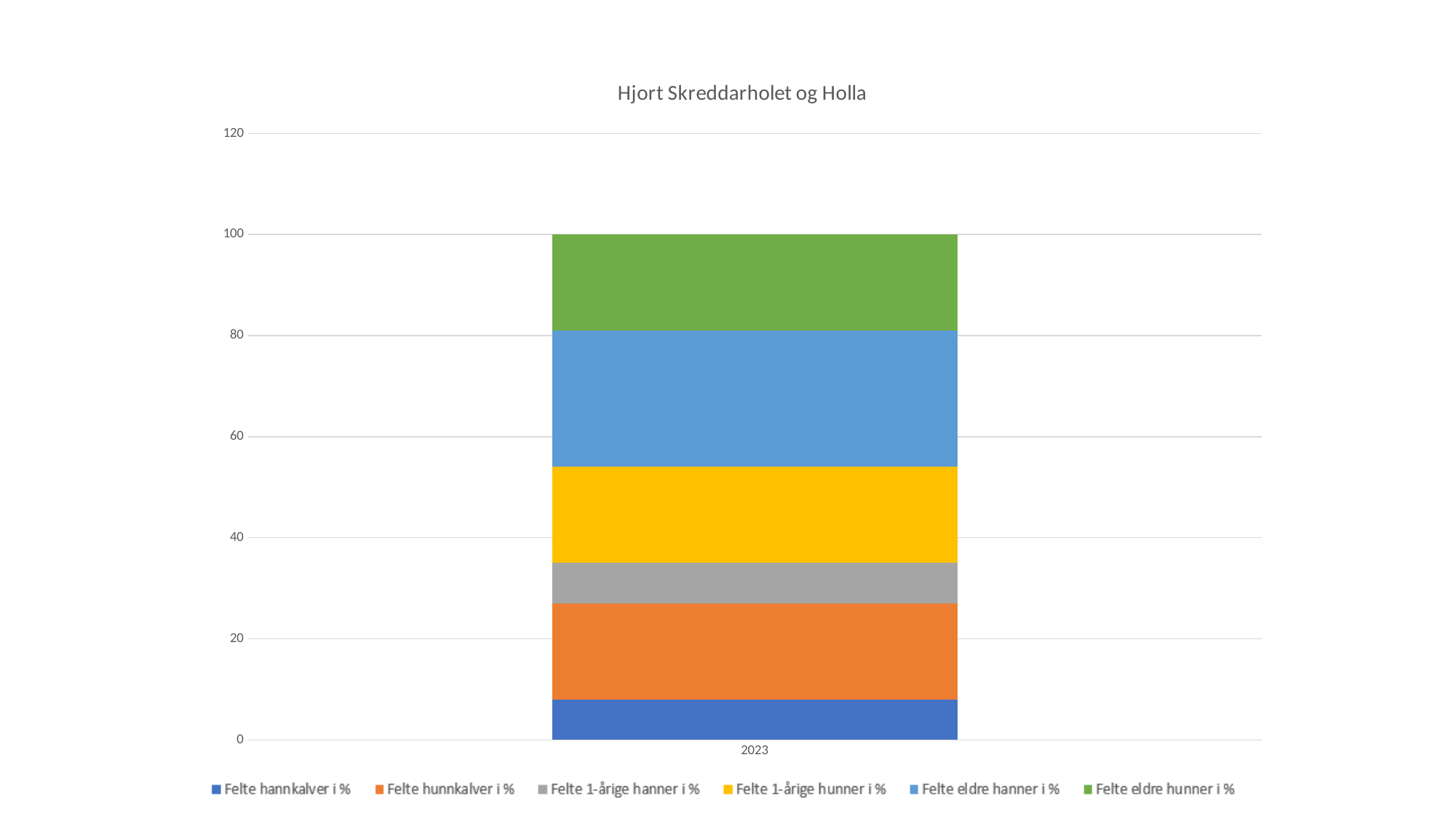
How many categories are shown on the x axis? 1 What is the title of the chart? Hjort Skreddarholet og Holla Is the value for Felte eldre hanner i % in 2023 greater or less than 20? greater Which segment is larger in the 2023 bar, Felte eldre hanner i % or Felte 1-årige hanner i %? Felte eldre hanner i % Which series has the largest segment in the 2023 bar? Felte eldre hanner i % Which segment is larger in the 2023 bar, Felte hannkalver i % or Felte hunnkalver i %? Felte hunnkalver i % How many series does the legend list? 6 What kind of chart is shown on the slide? Stacked bar chart Which year is shown on the x axis? 2023 Is the value for Felte hannkalver i % in 2023 greater or less than 20? less Is the total height of the 2023 stacked bar greater or less than 80? greater What is the total height of the stacked bar for 2023? 100